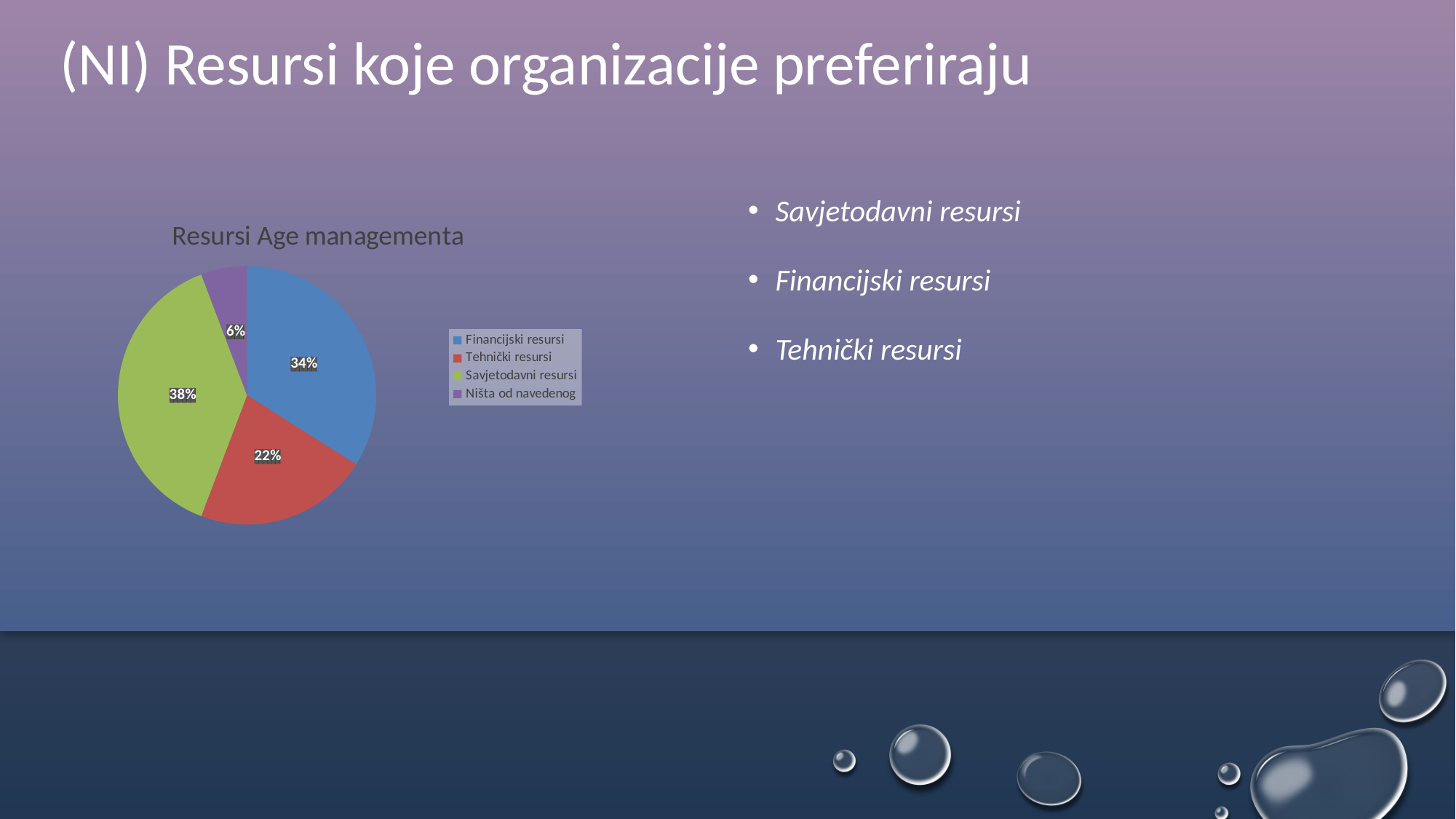
Which is larger, Financijski resursi or Tehnički resursi? Financijski resursi What share of the pie is Ništa od navedenog? 6% What colour is the Savjetodavni resursi slice? green What is the title of the chart? Resursi Age managementa What type of chart is shown on the slide? pie chart What share of the pie is Savjetodavni resursi? 38% Which category has the largest slice of the pie? Savjetodavni resursi What share of the pie is Tehnički resursi? 22% Which category has the smallest slice of the pie? Ništa od navedenog What share of the pie is Financijski resursi? 34% How many categories does the pie chart have? 4 What is the difference in percentage points between Savjetodavni resursi and Tehnički resursi? 16